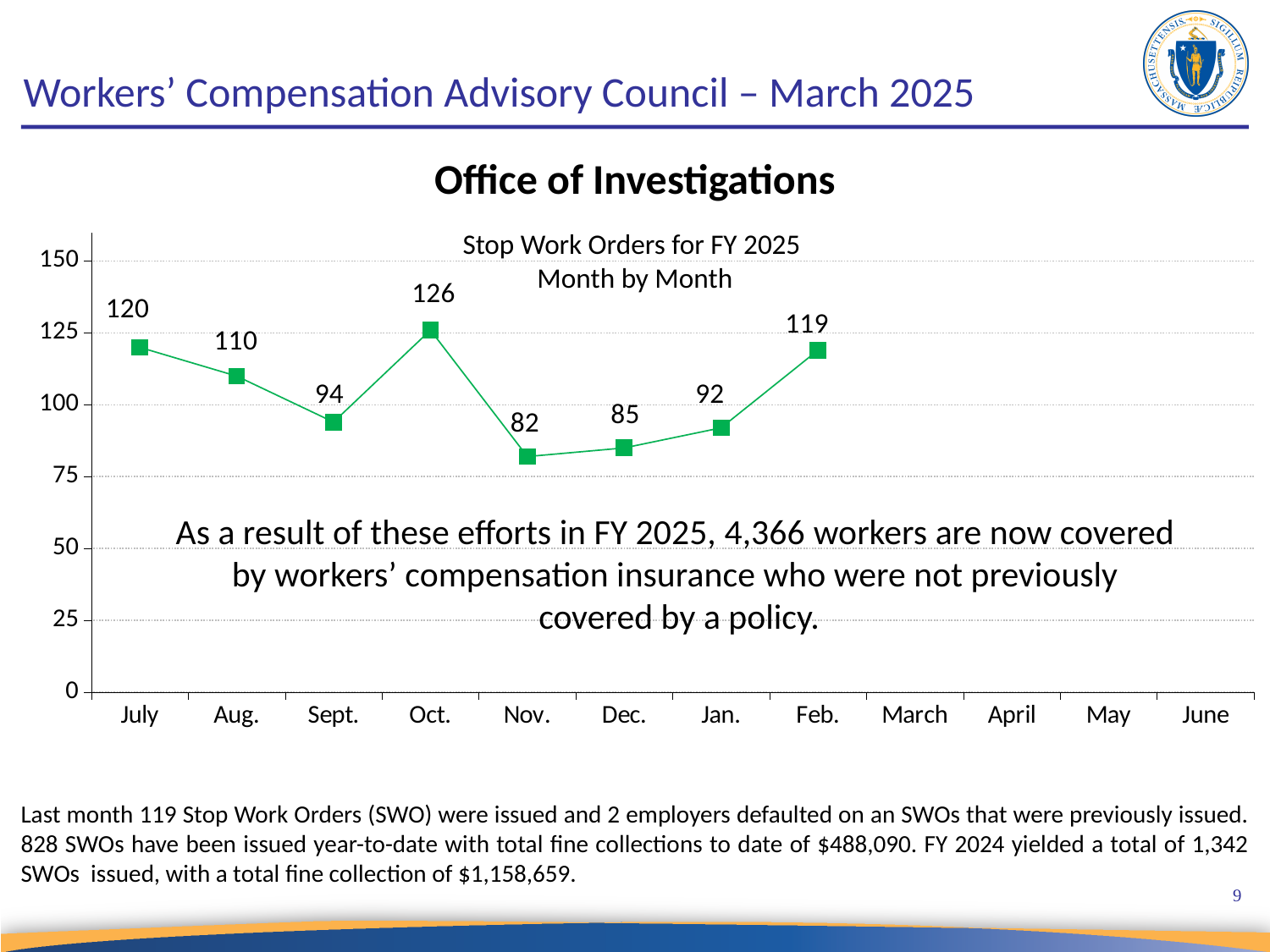
What is the number of Stop Work Orders for November? 82 What is the number of Stop Work Orders for October? 126 Which month has the highest number of Stop Work Orders? Oct. What is the difference between the Stop Work Orders in October and in November? 44 What is the number of Stop Work Orders for February? 119 What is the title of the chart? Stop Work Orders for FY 2025 Month by Month Which month has the lowest number of Stop Work Orders? Nov. What kind of chart is shown on the slide? Line chart What is the difference between the Stop Work Orders in July and in August? 10 Is the value for December greater or less than 100? less How many months have a plotted data point on the chart? 8 Which month has more Stop Work Orders, September or January? Sept.